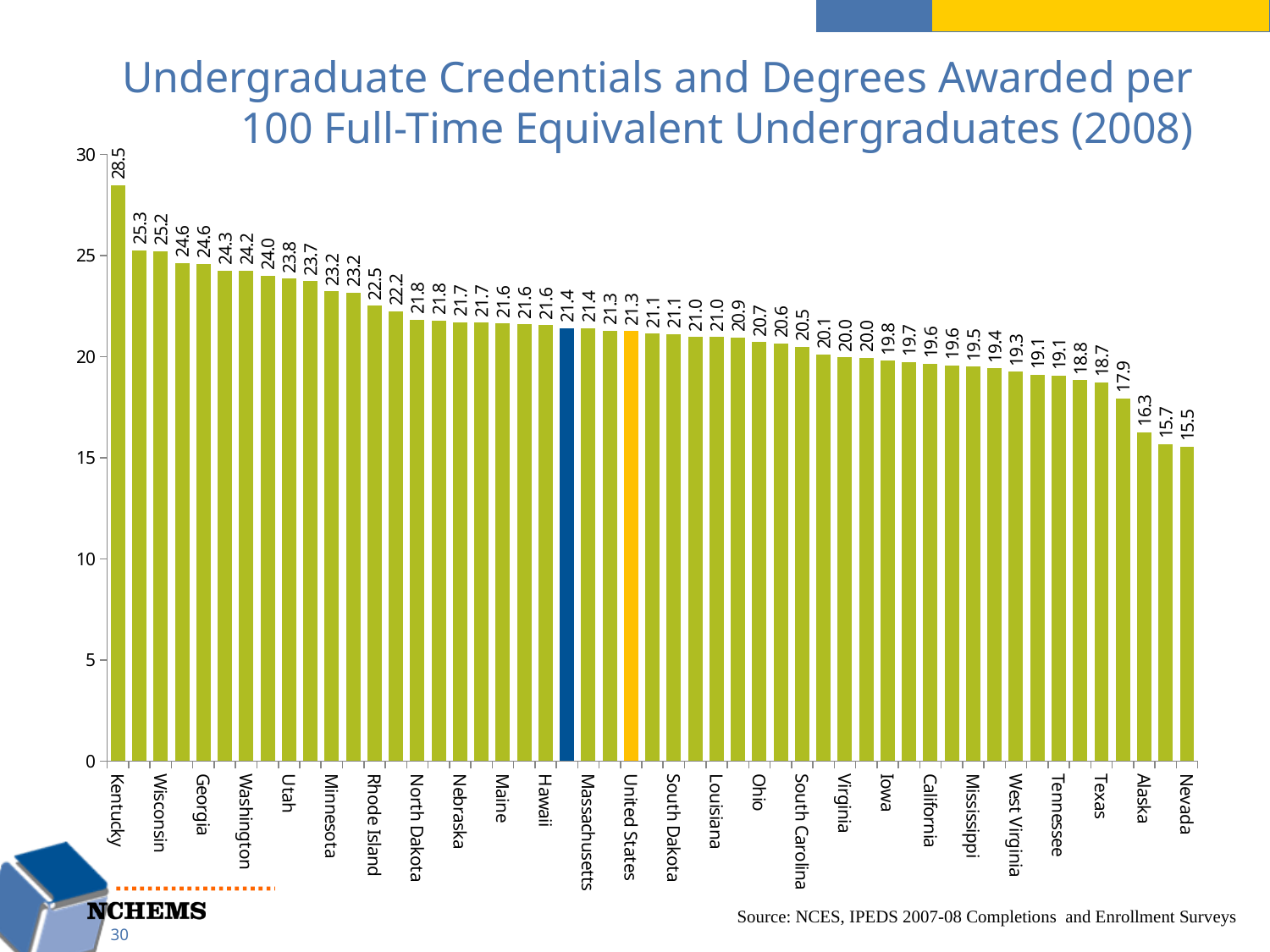
What is the value for the United States? 21.3 What is the difference between the values for Kentucky and Nevada? 13.0 What is the value for Nevada? 15.5 Which has a larger value, Kentucky or Nevada? Kentucky Which category is shown with an orange bar? United States Which state has the highest number of undergraduate credentials and degrees awarded per 100 FTE undergraduates? Kentucky Which state has the lowest value on the chart? Nevada How many bars are plotted on the chart? 51 Do the values rise or fall moving from left to right along the x axis? fall What kind of chart is shown on the slide? bar chart Is the value for Alaska greater or less than 20? less What is the value for Kentucky? 28.5